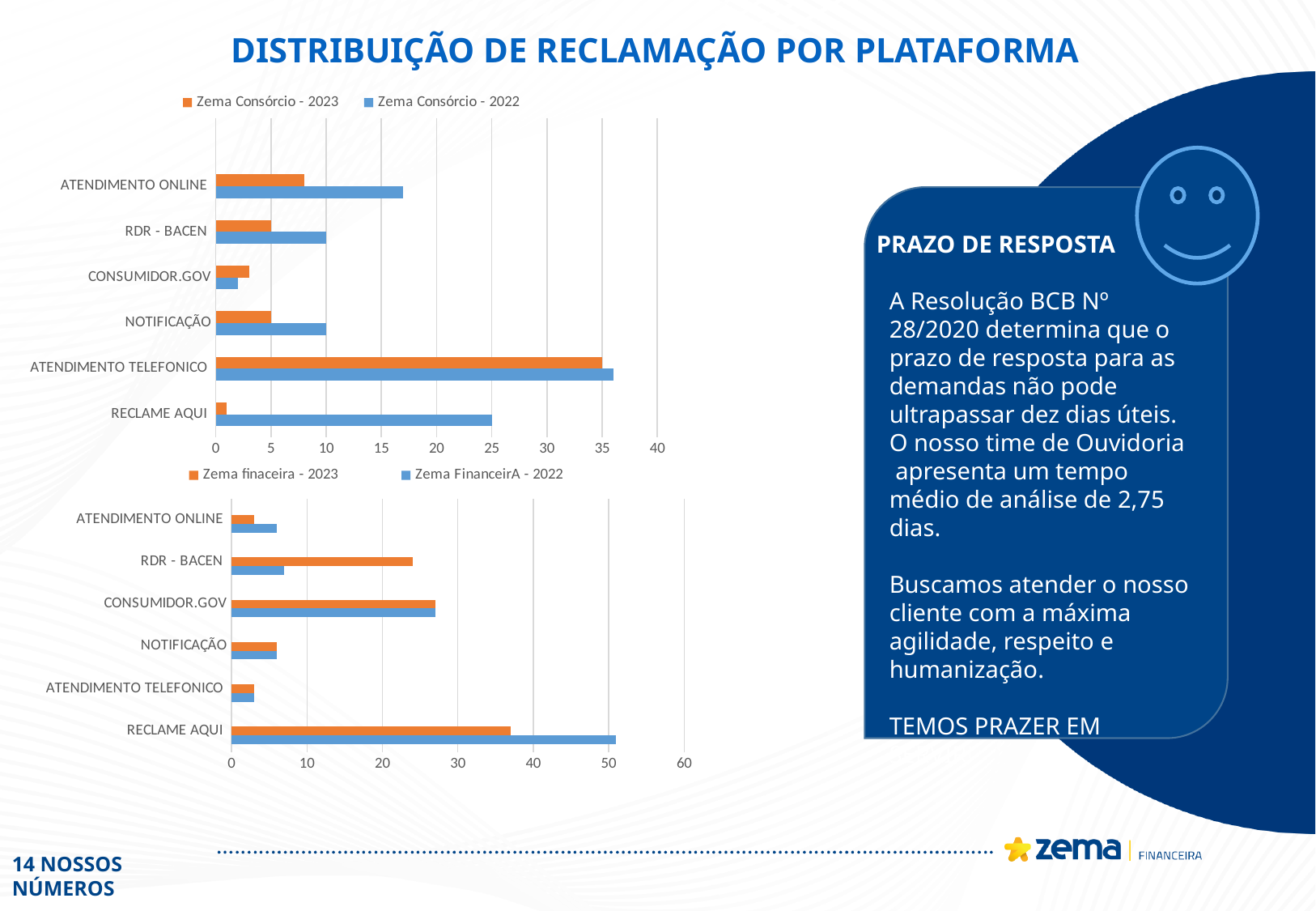
In the top chart (Zema Consórcio), is the value for RECLAME AQUI in Zema Consórcio - 2022 greater or less than 20? greater In the top chart (Zema Consórcio), which is larger for ATENDIMENTO ONLINE: Zema Consórcio - 2023 or Zema Consórcio - 2022? Zema Consórcio - 2022 What kind of chart is the top chart (Zema Consórcio)? bar chart In the top chart (Zema Consórcio), which category has the lowest value for Zema Consórcio - 2023? RECLAME AQUI How many categories does the bottom chart (Zema Financeira) show? 6 In the bottom chart (Zema Financeira), which is larger for RDR - BACEN: Zema finaceira - 2023 or Zema FinanceirA - 2022? Zema finaceira - 2023 In the bottom chart (Zema Financeira), which category has the highest value for Zema FinanceirA - 2022? RECLAME AQUI In the bottom chart (Zema Financeira), is the value for RDR - BACEN in Zema finaceira - 2023 greater or less than 20? greater What is the title shown above the charts on the slide? DISTRIBUIÇÃO DE RECLAMAÇÃO POR PLATAFORMA How many series does the legend of the top chart (Zema Consórcio) list? 2 In the top chart (Zema Consórcio), which category has the highest value for Zema Consórcio - 2022? ATENDIMENTO TELEFONICO